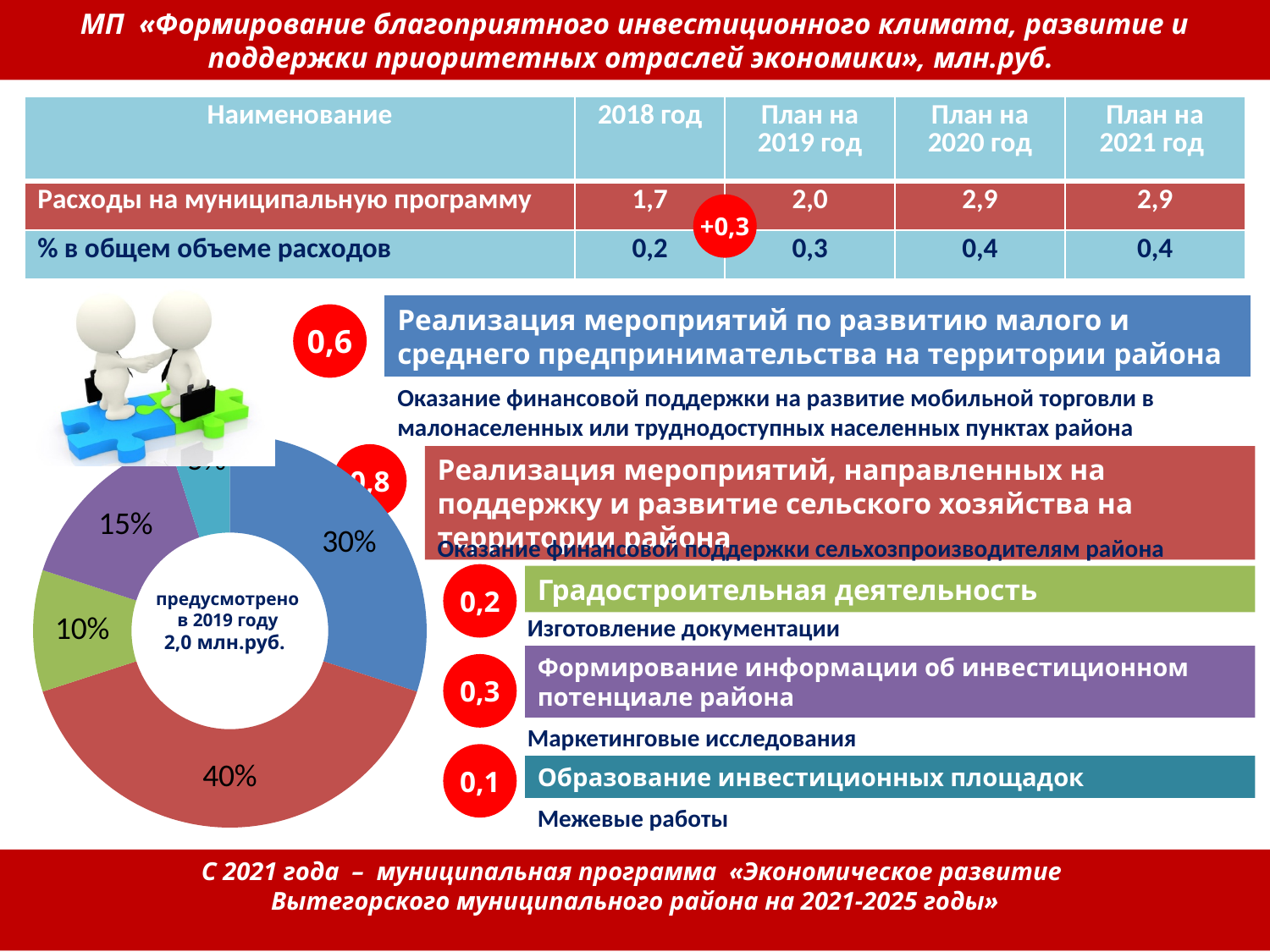
Which slice of the doughnut chart is the largest? The red slice (40%) Which is larger in the doughnut chart, the blue slice or the purple slice? The blue slice (30%) In the doughnut chart, what percentage is shown for the blue slice? 30% What kind of chart is shown on the left of the slide? Doughnut (pie) chart What total amount is stated in the centre of the doughnut chart as planned for 2019? 2,0 млн.руб. How many slices does the doughnut chart have? 5 What is the combined share of the red and blue slices in the doughnut chart? 70% What is the difference in percentage points between the red slice and the blue slice of the doughnut chart? 10 percentage points Which is larger in the doughnut chart, the purple slice or the green slice? The purple slice (15%) In the doughnut chart, what percentage is shown for the green slice? 10% In the doughnut chart, what percentage is shown for the red slice? 40% In the doughnut chart, what percentage is shown for the purple slice? 15%